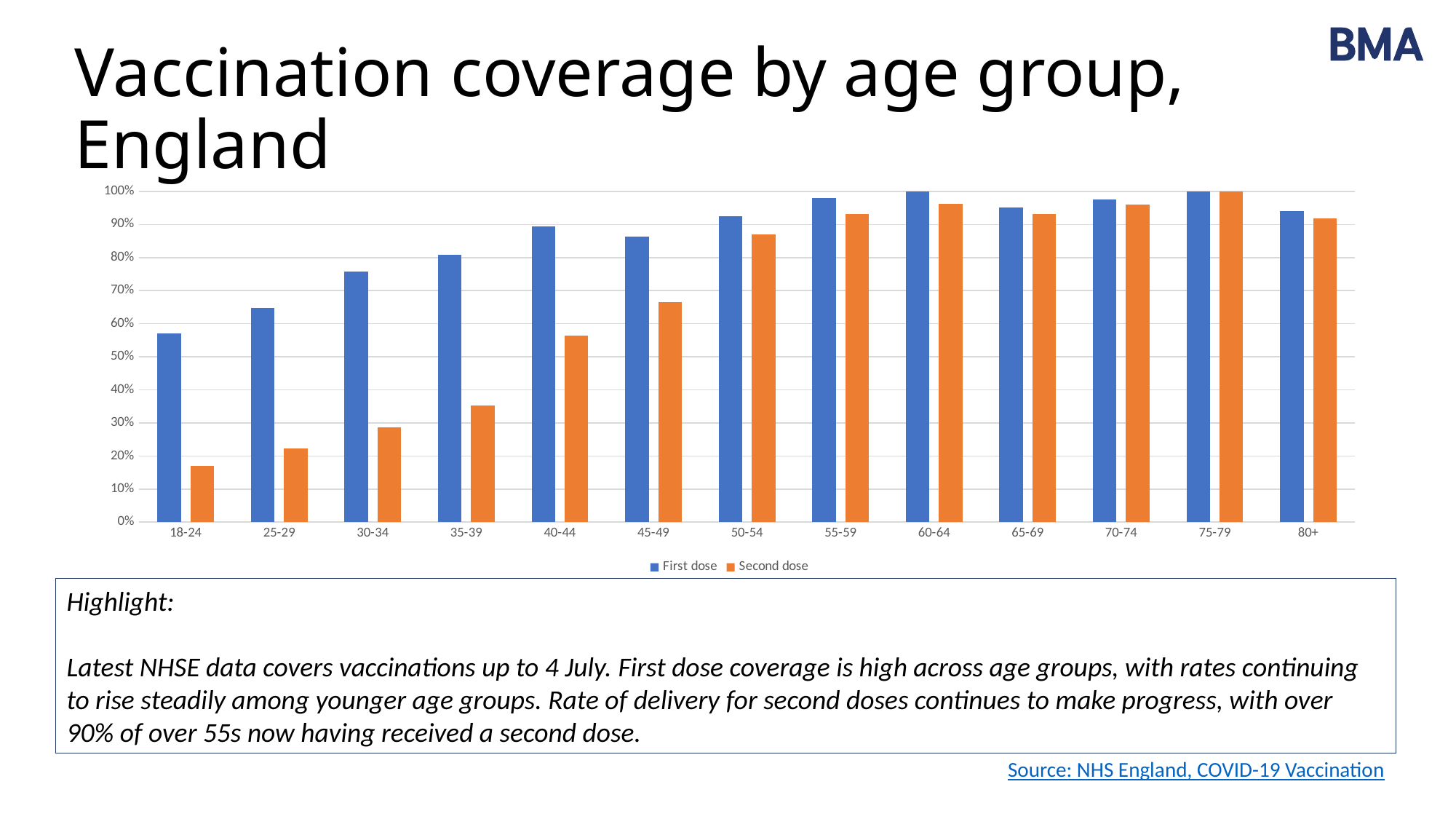
Which age group has the highest second dose coverage? 75-79 Which age group has the lowest first dose coverage? 18-24 Which age group has the lowest second dose coverage? 18-24 How many age groups are shown on the x axis of the chart? 13 What kind of chart is shown on the slide? Bar chart Which is larger, the second dose value for 45-49 or the second dose value for 50-54? 50-54 Is the second dose value for 35-39 greater or less than 40%? less Is the first dose value for 30-34 greater or less than 70%? greater Is the second dose value for 40-44 greater or less than 50%? greater How many series does the chart's legend list? 2 Does second dose coverage generally rise or fall from the 18-24 age group to the 75-79 age group? Rise